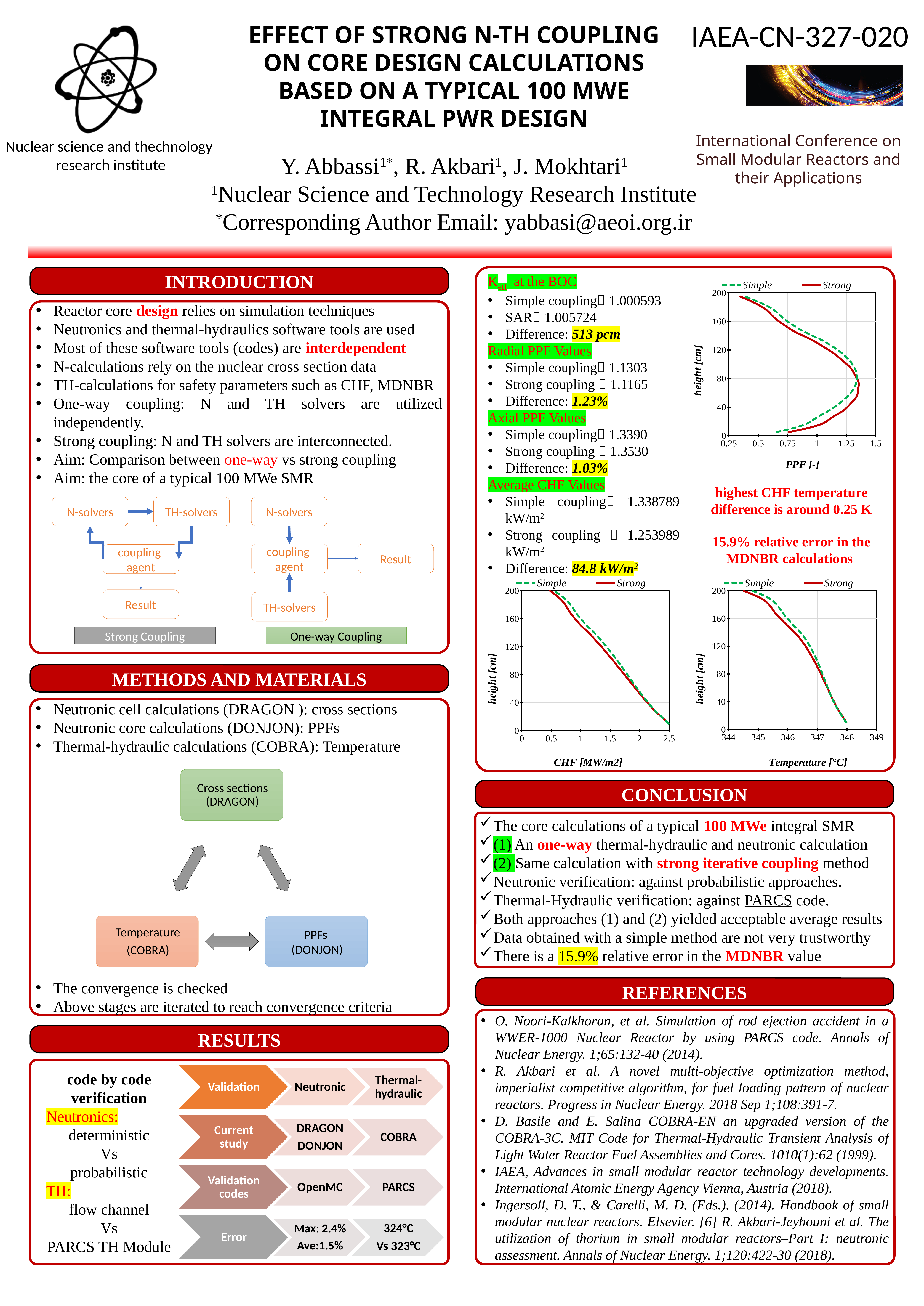
What kind of chart is the PPF chart at the top right of the slide? line chart In the CHF chart, is the CHF value at a height of 40 cm greater or less than 2? greater In the Temperature chart, is the temperature at a height of 200 cm greater or less than 345? less In the CHF chart, is the CHF value at a height of 200 cm greater or less than 1? less What are the two series named in the legend of the CHF chart? Simple and Strong In the CHF chart, does CHF rise or fall as height increases from 0 to 200 cm? fall How many series does the legend of the PPF chart list? 2 What is the x-axis label of the chart at the bottom right of the results panel? Temperature [°C] In the Temperature chart, does temperature rise or fall as height increases from 0 to 200 cm? fall